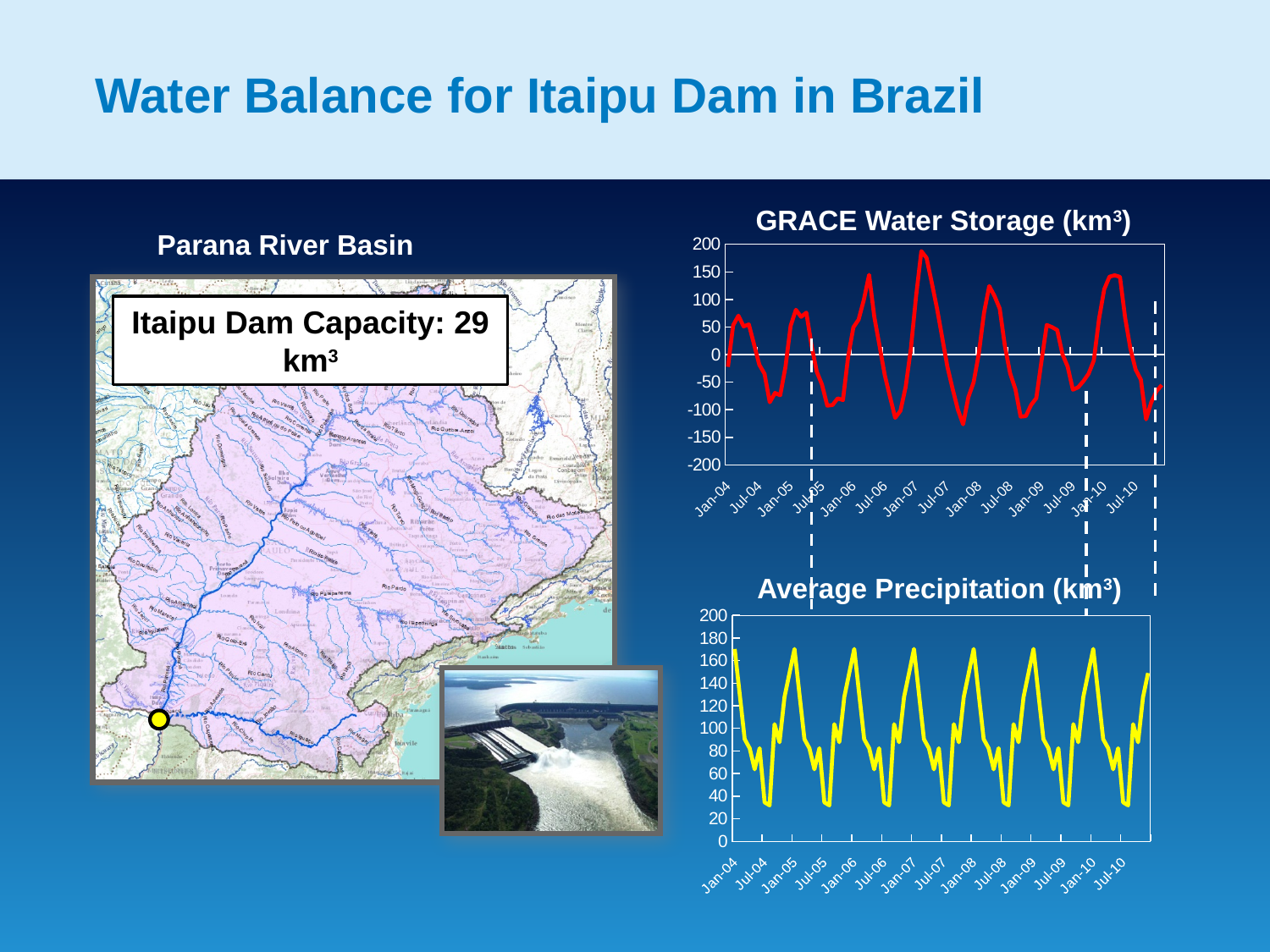
What kind of chart is the Average Precipitation chart? line chart What kind of chart is the GRACE Water Storage chart? line chart In the GRACE Water Storage chart, is the lowest point of the line (around Jan-08) greater or less than -100? less In the Average Precipitation chart, is the value at Jan-04 greater or less than 140? greater In the Average Precipitation chart, are the peaks of the line greater or less than 150? greater What is the title of the upper chart on the right side of the slide? GRACE Water Storage (km³) How many x-axis tick labels are shown on the Average Precipitation chart? 14 What is the lowest value shown on the y-axis of the GRACE Water Storage chart? -200 What is the highest value shown on the y-axis of the Average Precipitation chart? 200